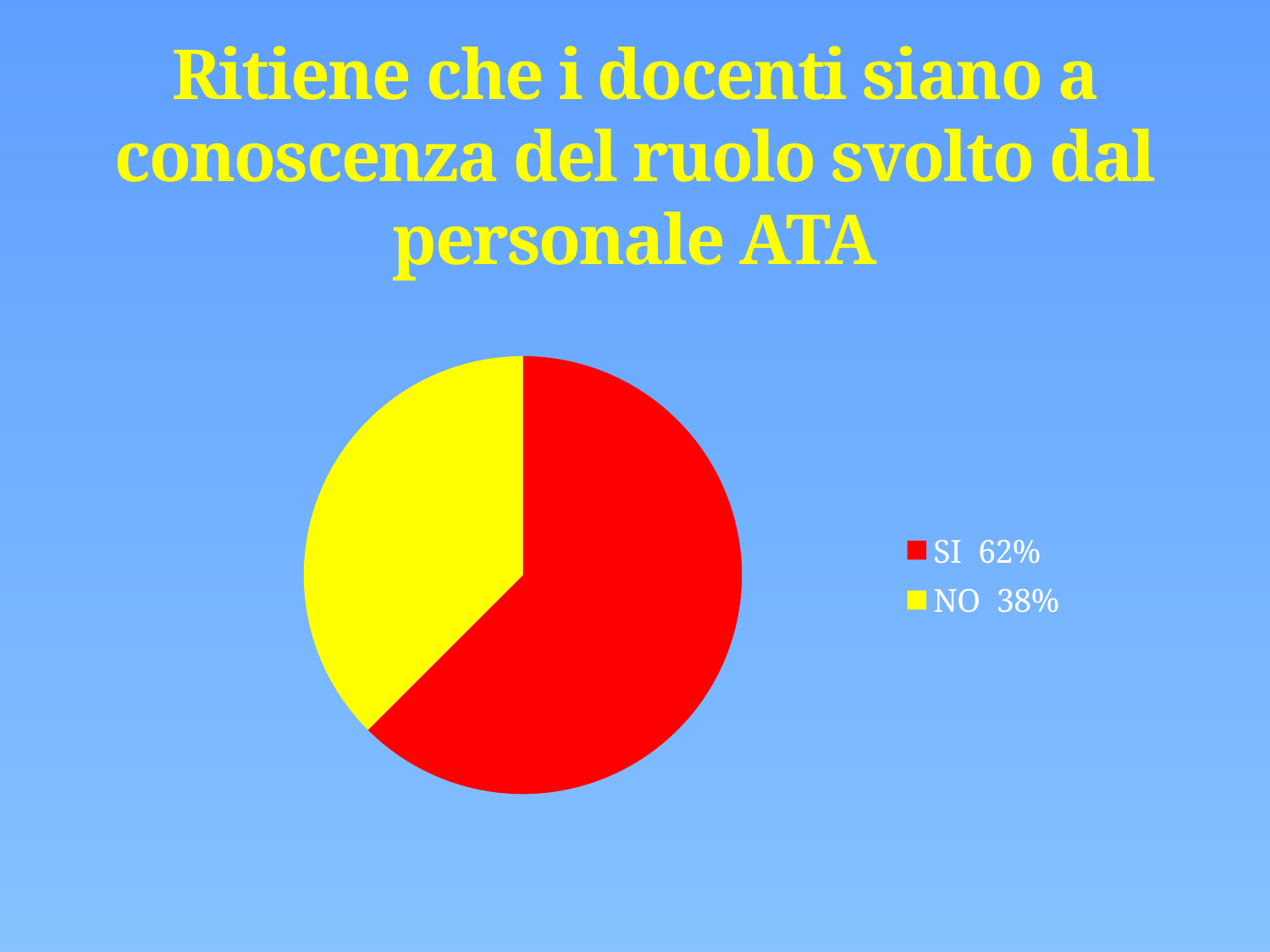
What share of the pie does the SI slice represent? 62% Which slice is the largest in the pie chart? SI What colour is the NO slice? yellow How many entries does the legend list? 2 Which is larger, the SI slice or the NO slice? SI What share of the pie does the NO slice represent? 38% What is the difference in percentage points between the SI and NO slices? 24 What colour is the SI slice? red Is the share for SI greater or less than 50%? greater How many slices does the pie chart have? 2 Which slice is the smallest in the pie chart? NO What kind of chart is shown on the slide? pie chart